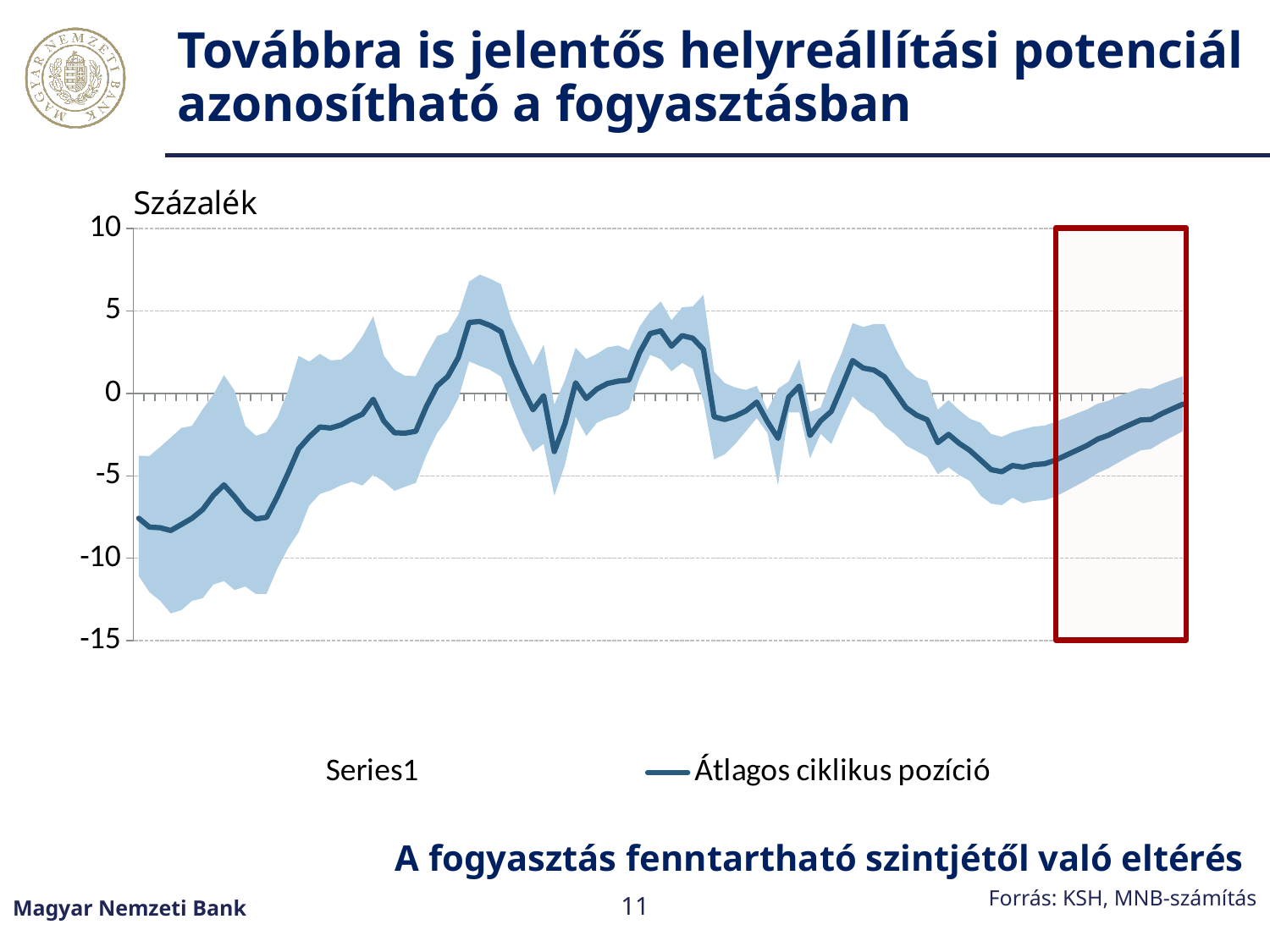
What is the name of the series drawn as a dark blue line in the chart? Átlagos ciklikus pozíció Is the lowest point reached by the Átlagos ciklikus pozíció line greater or less than -5? less Which is larger: the value of the Átlagos ciklikus pozíció line at the left end of the chart or at the right end? right end Is the value of the Átlagos ciklikus pozíció line at the right end of the chart greater or less than -5? greater Is the value of the Átlagos ciklikus pozíció line at the left end of the chart greater or less than -5? less How many entries does the chart's legend list? 2 What unit label is shown above the vertical axis of the chart? Százalék What is the lowest value shown on the chart's vertical axis? -15 What kind of chart is shown on the slide? combination area and line chart What is the highest value shown on the chart's vertical axis? 10 Within the red-outlined area at the right of the chart, does the Átlagos ciklikus pozíció line rise or fall from left to right? rise